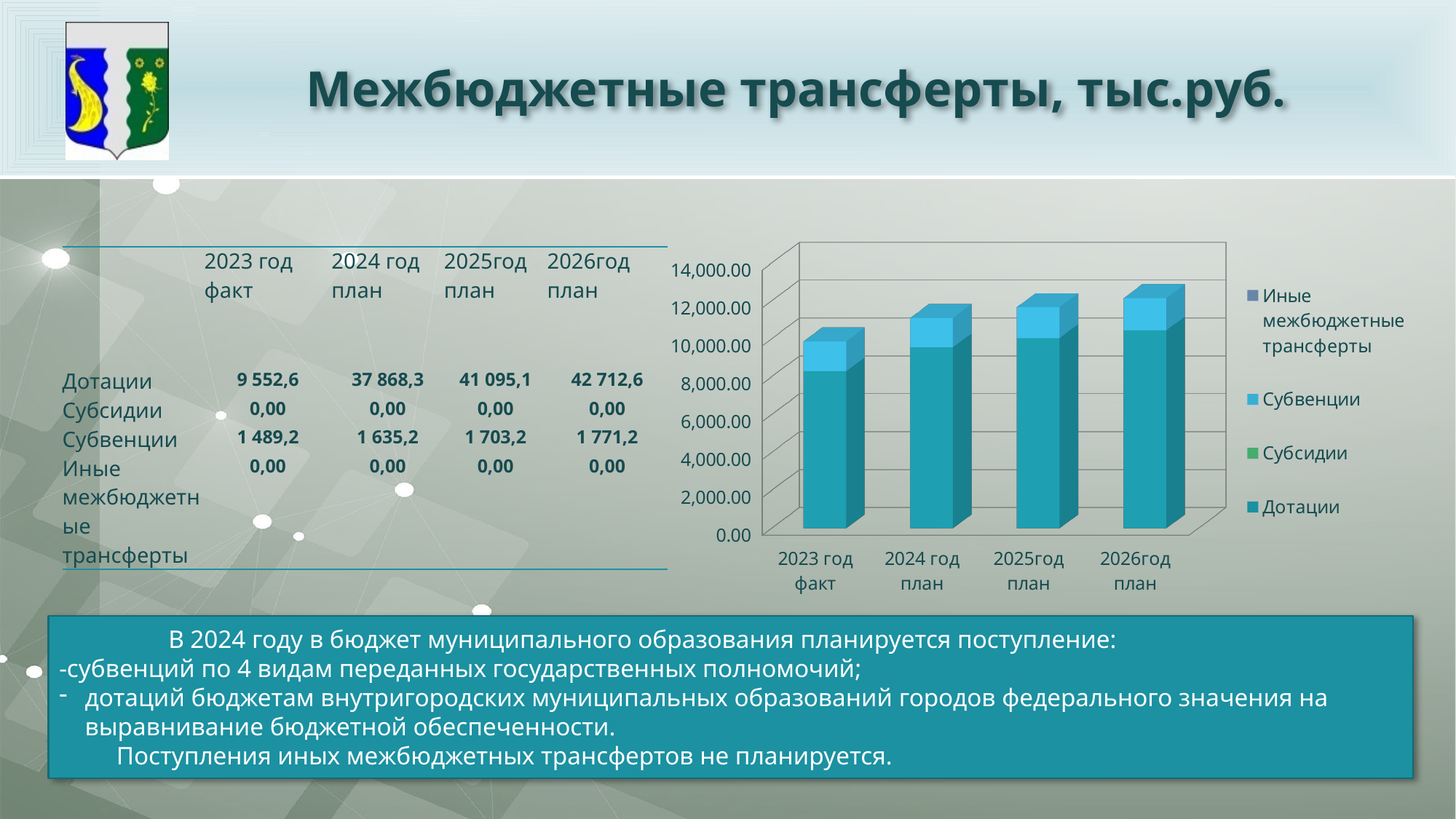
Is the total bar for 2026год план greater or less than 10,000.00? greater Which year has the tallest bar in the chart? 2026год план Which year has the shortest bar in the chart? 2023 год факт What kind of chart is shown on the slide? Stacked bar chart Is the total bar for 2023 год факт greater or less than 12,000.00? less Is the Дотации segment for 2023 год факт greater or less than 10,000.00? less Do the bar heights rise or fall from 2023 год факт to 2026год план? Rise How many series does the chart legend list? 4 Which bar is taller: 2024 год план or 2026год план? 2026год план How many categories (years) are shown on the x axis of the chart? 4 Which series is listed last (at the bottom) in the chart legend? Дотации